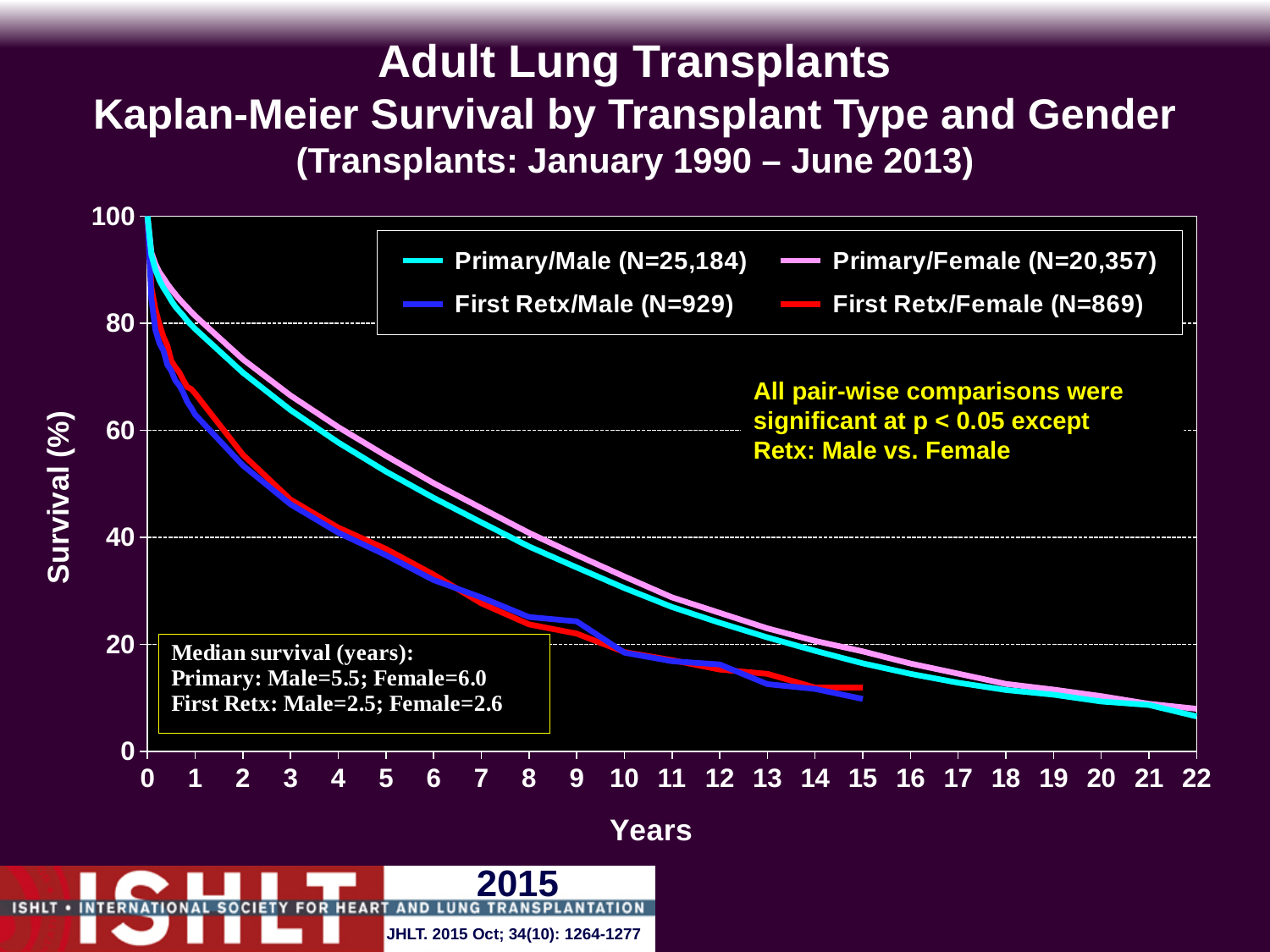
Is the survival value for Primary/Male at 5 years greater or less than 40? greater What is the N for the First Retx/Female series in the legend? 869 What kind of chart is shown on the slide? line chart According to the text box, what is the median survival in years for First Retx Male recipients? 2.5 How many series does the legend list? 4 What colour is the Primary/Male line in the legend? cyan At 10 years, which is larger: survival for Primary/Female or for First Retx/Female? Primary/Female What is the N for the Primary/Male series in the legend? 25,184 According to the text box, what is the median survival in years for Primary Female recipients? 6.0 Is the survival value for Primary/Female at 15 years greater or less than 20? less Do the survival curves rise or fall as years increase? fall Which series has the highest survival at 10 years? Primary/Female